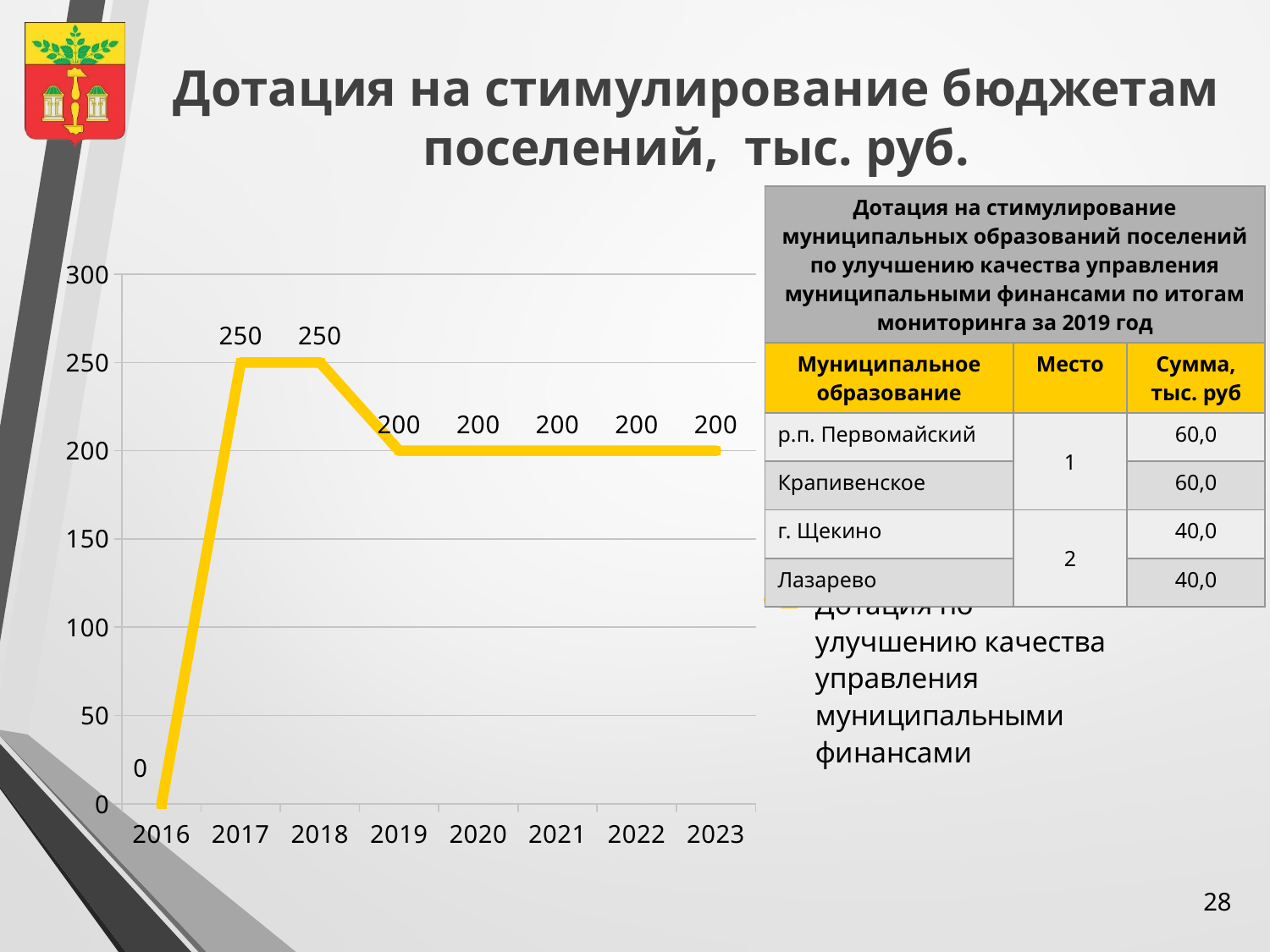
What is the difference between the values for 2018 and 2019 in the line chart? 50 Does the value in the line chart rise or fall from 2018 to 2019? fall What is the value for 2020 in the line chart? 200 What type of chart is shown on the slide? line chart How many years are plotted on the x axis of the line chart? 8 Which is larger in the line chart, the value for 2018 or the value for 2021? 2018 What is the value for 2017 in the line chart? 250 What is the value for 2023 in the line chart? 200 What is the value for 2016 in the line chart? 0 What is the difference between the values for 2017 and 2016 in the line chart? 250 Which year has the lowest value in the line chart? 2016 What colour is the line in the line chart? yellow